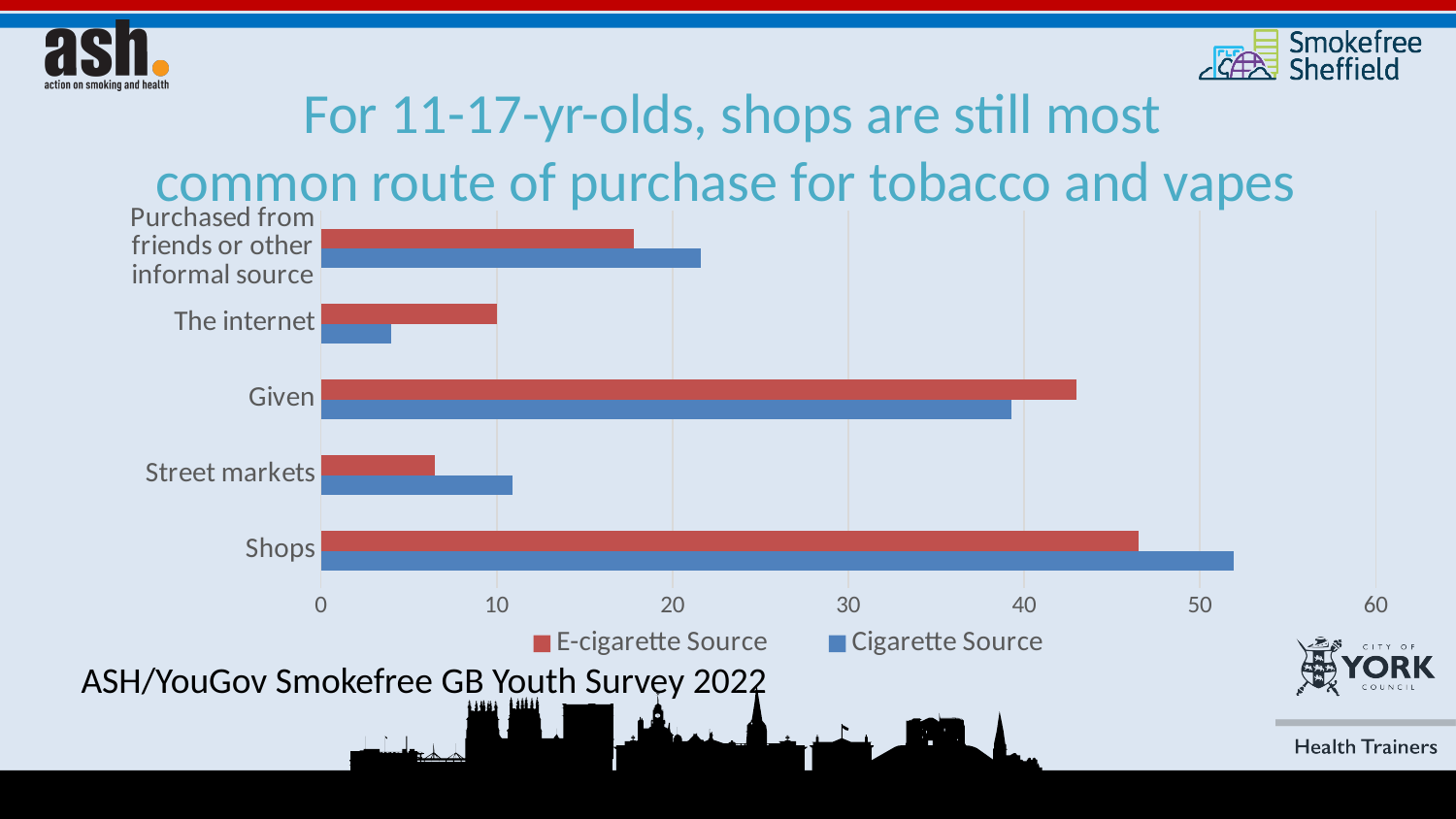
How many categories are shown on the chart? 5 Which category has the highest value for E-cigarette Source? Shops Is the Cigarette Source value for Shops greater or less than 50? greater Is the Cigarette Source value for The internet greater or less than 10? less What kind of chart is shown on the slide? bar chart For Street markets, which is larger: the E-cigarette Source value or the Cigarette Source value? Cigarette Source Which colour represents the Cigarette Source series? blue Which category has the lowest value for E-cigarette Source? Street markets How many series does the legend list? 2 Which category has the lowest value for Cigarette Source? The internet Which category has the highest value for Cigarette Source? Shops Is the E-cigarette Source value for Given greater or less than 40? greater